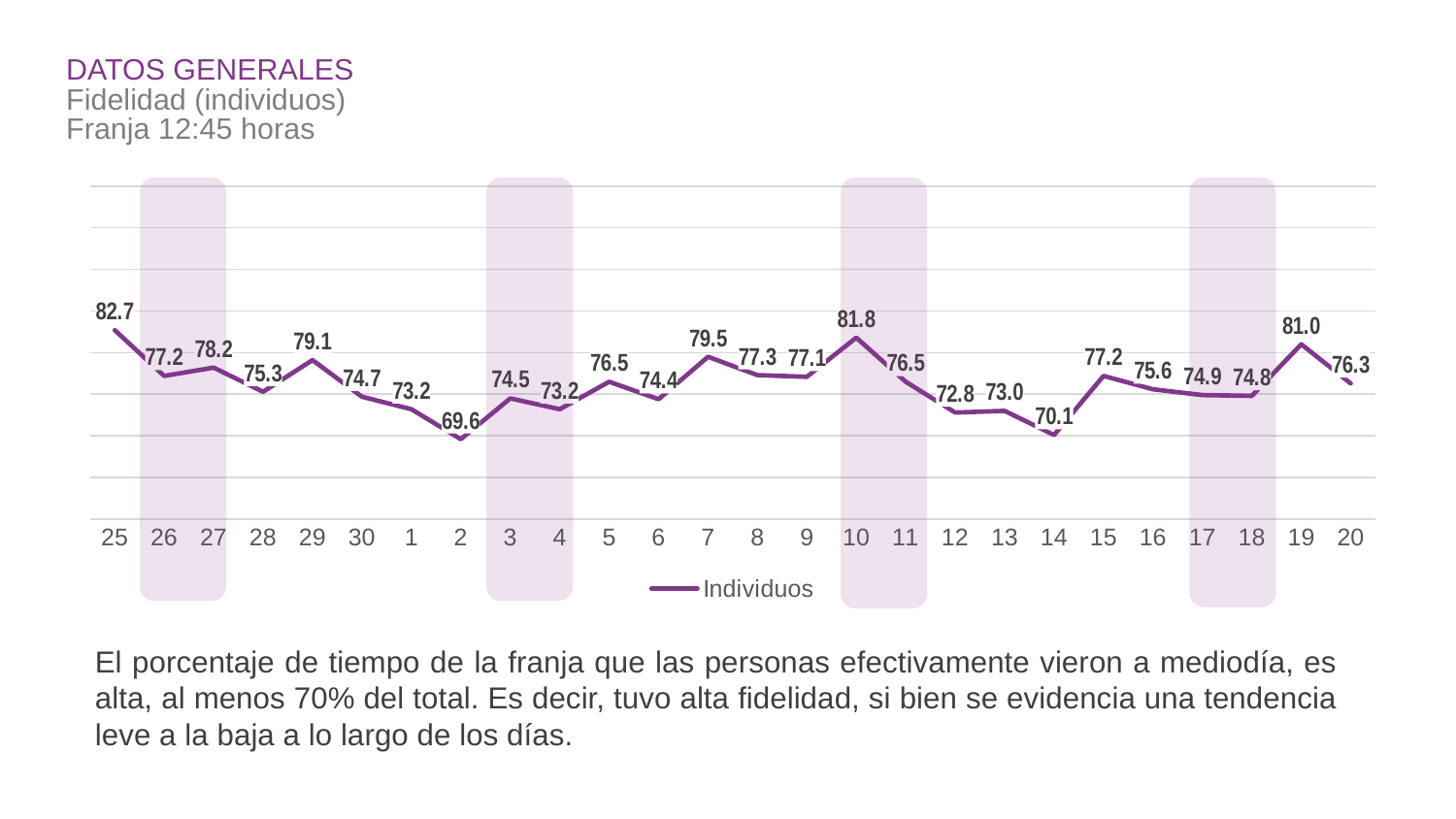
What is the value for day 25? 82.7 What is the name of the series shown in the legend? Individuos What type of chart is shown on the slide? line chart What is the difference between the values for day 25 and day 2? 13.1 Which day has the lowest value? 2 How many data points are plotted on the line? 26 How many series does the legend list? 1 What is the value for day 10? 81.8 Which is larger, the value for day 7 or the value for day 14? day 7 What is the value for day 19? 81.0 What is the value for day 2? 69.6 Which day has the highest value? 25